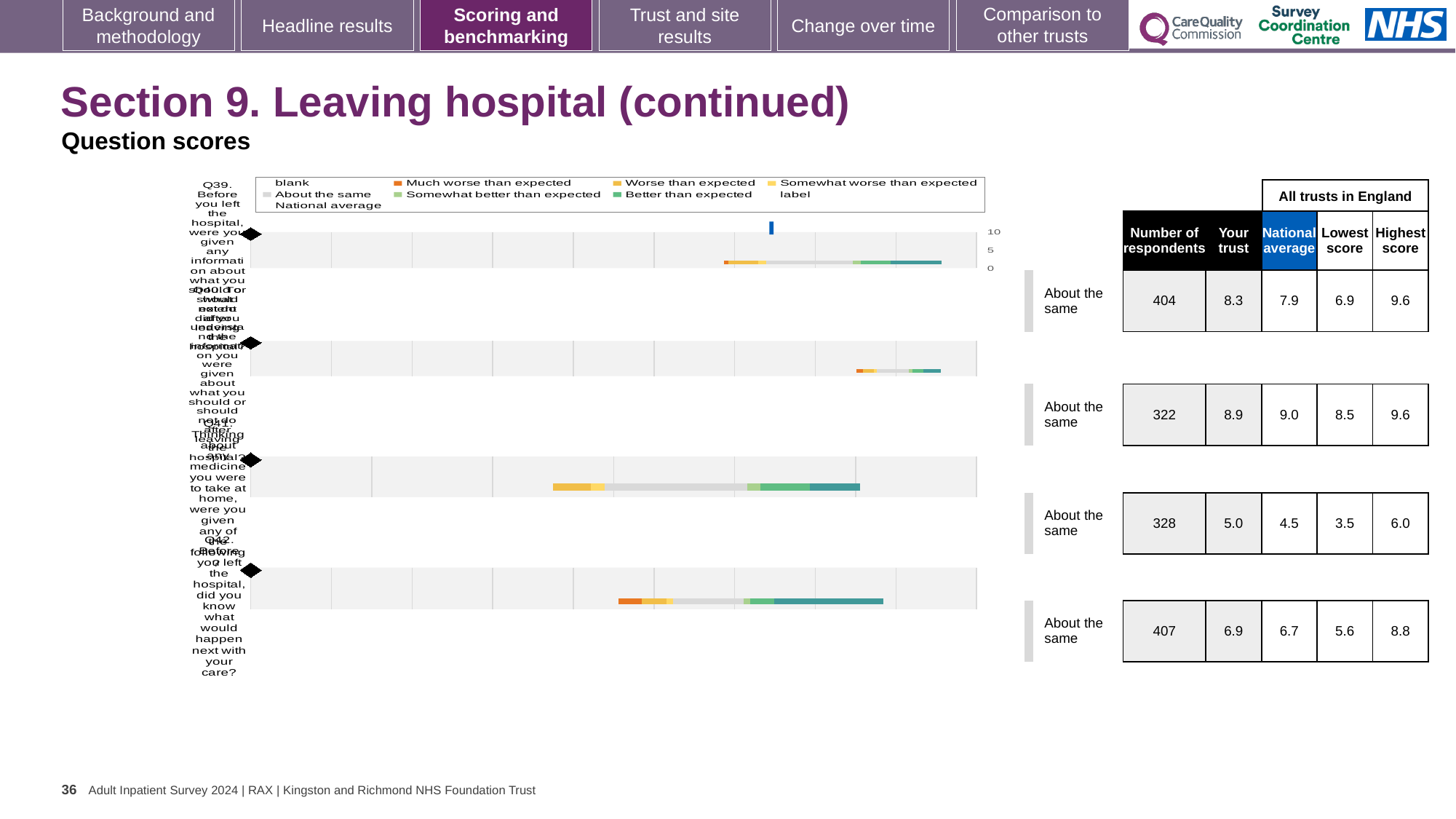
In the table beside the charts, what is the number of respondents in the first row (Q39)? 404 In the table beside the charts, what is the difference between the 'Your trust' score and the national average in the first row (Q39)? 0.4 In the table beside the charts, what is the national average in the first row (Q39)? 7.9 What kind of chart is used for the four question-score charts on the slide? bar chart How many question-score charts are shown on the slide? 4 In the table beside the charts, what is the 'Your trust' score in the bottom row (Q42)? 6.9 In the table beside the charts, which is larger in the first row (Q39): the 'Your trust' score or the national average? Your trust In the table beside the charts, what is the highest score in the bottom row (Q42)? 8.8 In the table beside the charts, what is the 'Your trust' score in the first row (Q39)? 8.3 In the table beside the charts, which row has the highest 'Your trust' score? the second row (8.9) In the legend above the charts, which colour represents 'Much worse than expected'? orange In the table beside the charts, what is the lowest score in the third row? 3.5